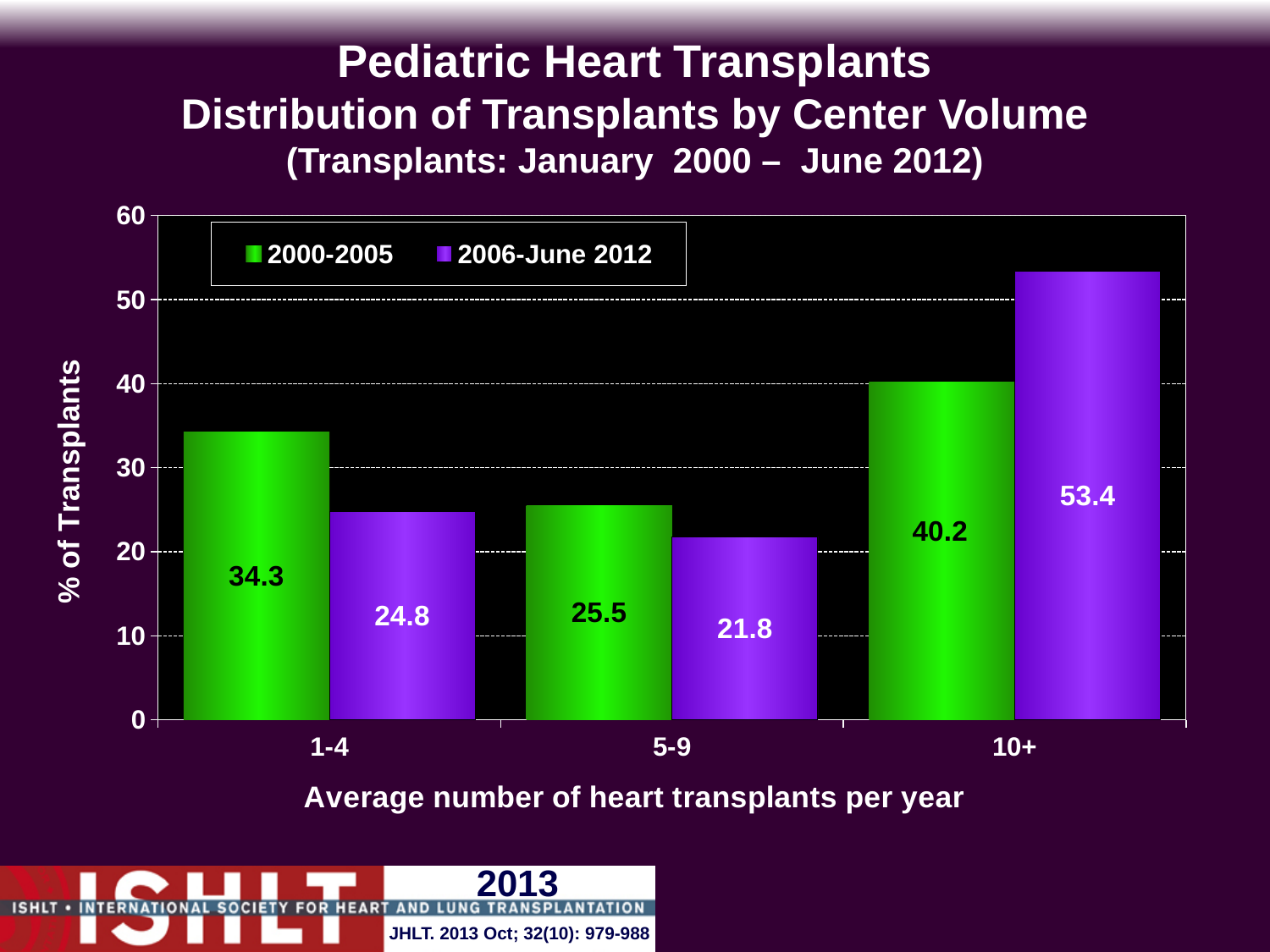
What kind of chart is shown on the slide? bar chart Which category has the lowest value in the 2006-June 2012 series? 5-9 What is the difference between the 2006-June 2012 and 2000-2005 values for the 10+ category? 13.2 Which category has the highest value in the 2000-2005 series? 10+ How many categories are shown on the x axis? 3 How many series does the legend list? 2 What is the value for the 5-9 category in the 2006-June 2012 series? 21.8 What is the value for the 10+ category in the 2006-June 2012 series? 53.4 What is the label of the y axis? % of Transplants For the 1-4 category, which series has the larger value, 2000-2005 or 2006-June 2012? 2000-2005 What is the value for the 1-4 category in the 2000-2005 series? 34.3 Is the value for the 10+ category in the 2006-June 2012 series greater or less than 50? greater